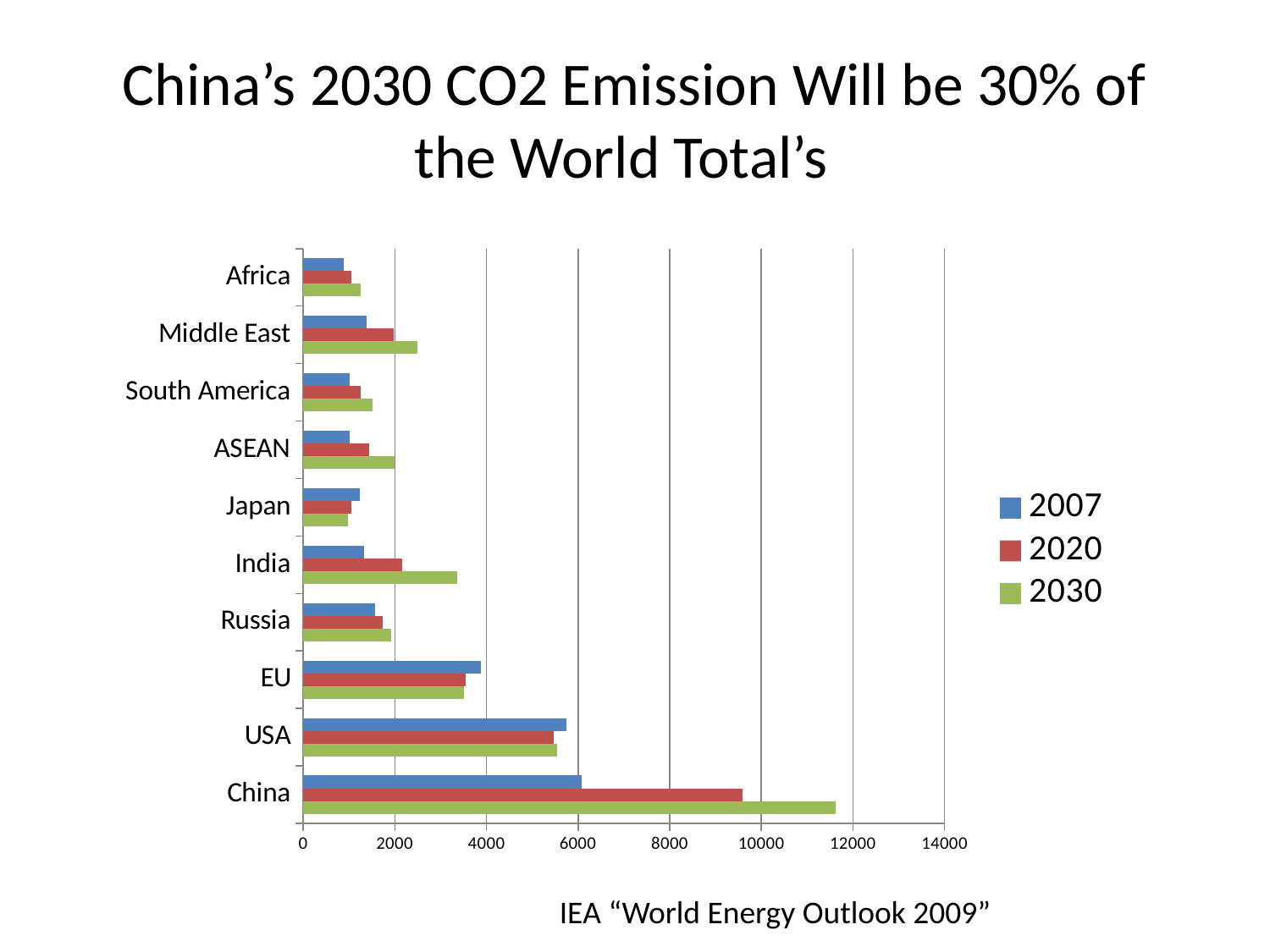
How many series does the legend list? 3 Which country or region has the highest 2030 value? China What source is cited below the chart? IEA "World Energy Outlook 2009" What kind of chart is shown on the slide? bar chart Is the 2030 value for USA greater or less than 4000? greater Which is larger, the 2020 value for China or the 2020 value for USA? China Is the 2030 value for China greater or less than 10000? greater Which country or region has the lowest 2030 value? Japan Is the 2007 value for China greater or less than 8000? less What are the three series listed in the legend? 2007, 2020, 2030 How many countries or regions are plotted on the chart? 10 Do China's values rise or fall from 2007 to 2030? rise